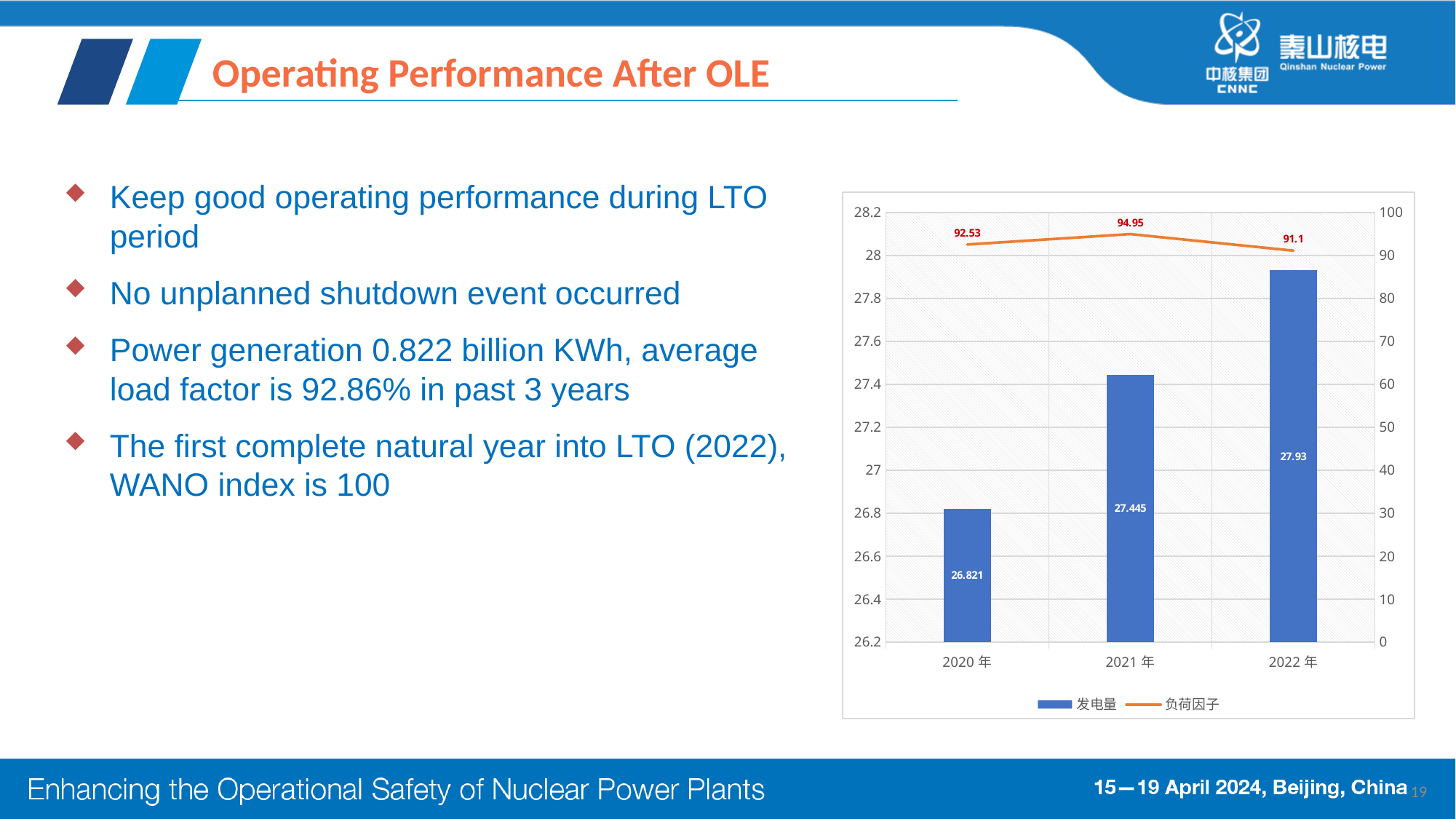
What is the value of the bar for 2022 年? 27.93 Do the bar values rise or fall from 2020 年 to 2022 年? rise What is the value of the 负荷因子 line for 2021 年? 94.95 What is the value of the bar for 2020 年? 26.821 Which year has the highest bar value? 2022 年 What colour is the 负荷因子 line? orange How many series does the legend list? 2 Which is larger, the 负荷因子 value for 2020 年 or for 2021 年? 2021 年 Which year has the lowest 负荷因子 value? 2022 年 What is the value of the 负荷因子 line for 2022 年? 91.1 How many years are shown on the x axis? 3 What is the difference between the bar values for 2022 年 and 2020 年? 1.109